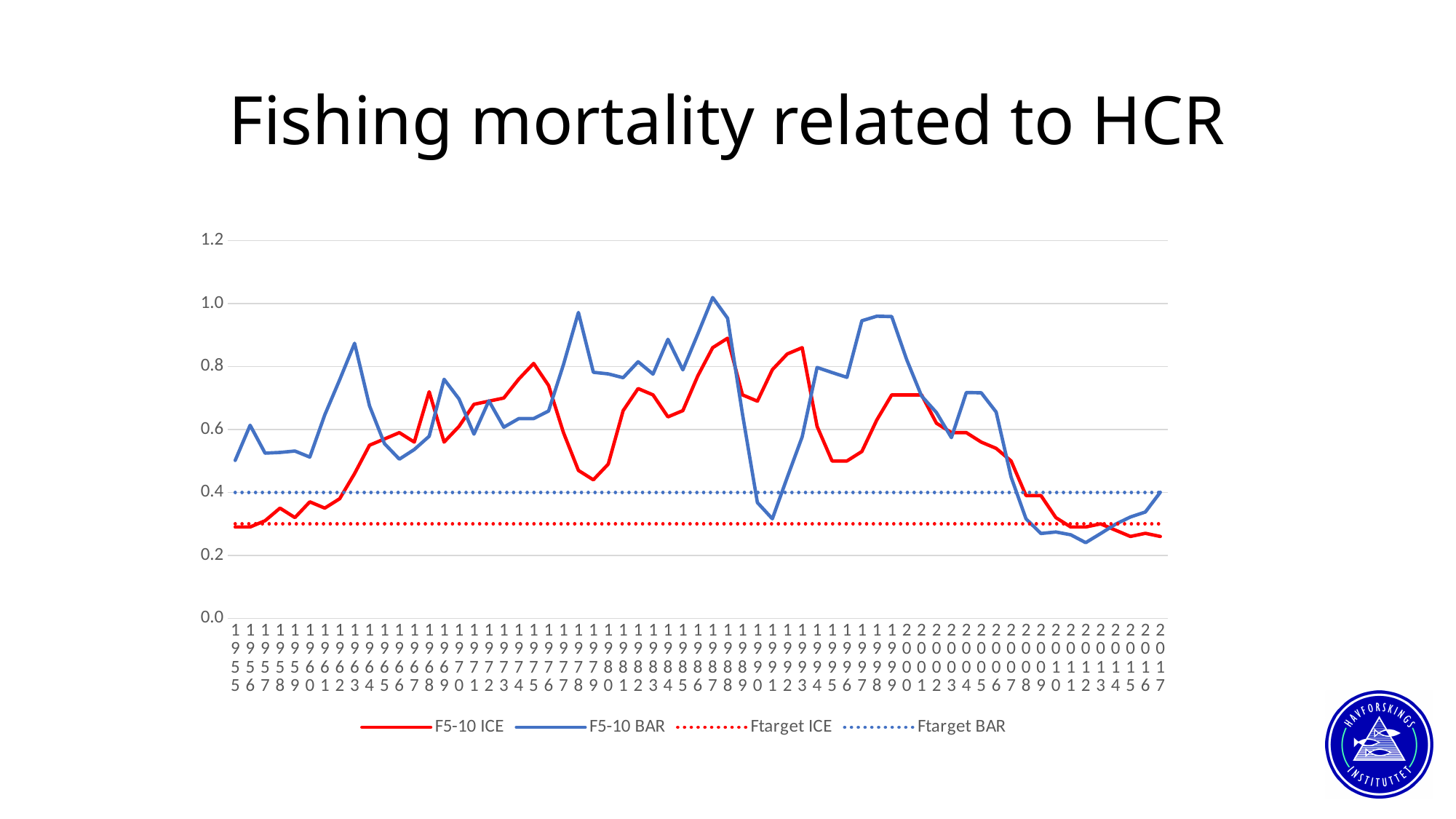
What kind of chart is shown on the slide? line chart What is the value of the Ftarget BAR line? 0.4 Which solid series reaches the highest value on the chart, F5-10 ICE or F5-10 BAR? F5-10 BAR Which of the two target lines, Ftarget ICE or Ftarget BAR, is higher? Ftarget BAR Which series is drawn as a solid red line? F5-10 ICE Is the value of F5-10 ICE in 1979 greater or less than 0.6? less In 1978, which series has the larger value, F5-10 ICE or F5-10 BAR? F5-10 BAR Is the value of F5-10 BAR in 1963 greater or less than 0.8? greater How many series does the legend list? 4 Is the value of F5-10 BAR in 2014 greater or less than 0.4? less What is the title of the chart? Fishing mortality related to HCR In 1992, which series has the larger value, F5-10 ICE or F5-10 BAR? F5-10 ICE